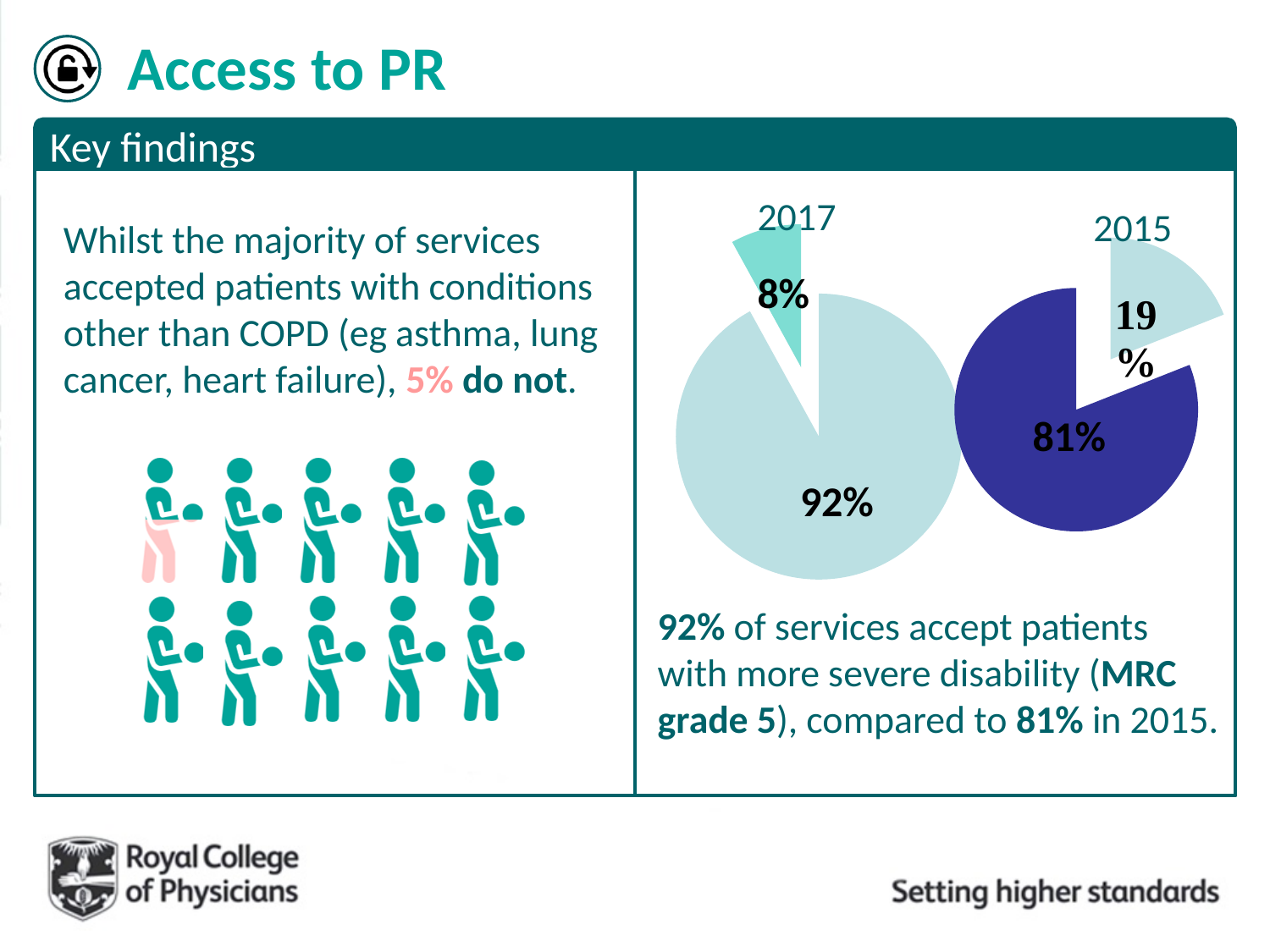
What is the difference between the smaller slice of the 2015 pie chart (19%) and the smaller slice of the 2017 pie chart (8%)? 11 percentage points How many slices does the 2017 pie chart have? 2 In the 2015 pie chart, what share of the pie does the smaller slice represent? 19% What colour is the larger slice of the 2015 pie chart? Dark blue In the 2017 pie chart, what value is shown for the smaller, exploded slice? 8% What kind of chart is the 2017 chart on the right side of the slide? Pie chart Which pie chart has the larger main slice, 2017 or 2015? 2017 In the 2015 pie chart, what value is shown for the smaller, exploded slice? 19% In the 2017 pie chart, what value is shown for the larger slice? 92% How many pie charts are shown on the slide? 2 What is the difference between the larger slice of the 2017 pie chart (92%) and the larger slice of the 2015 pie chart (81%)? 11 percentage points In the 2015 pie chart, what value is shown for the larger slice? 81%